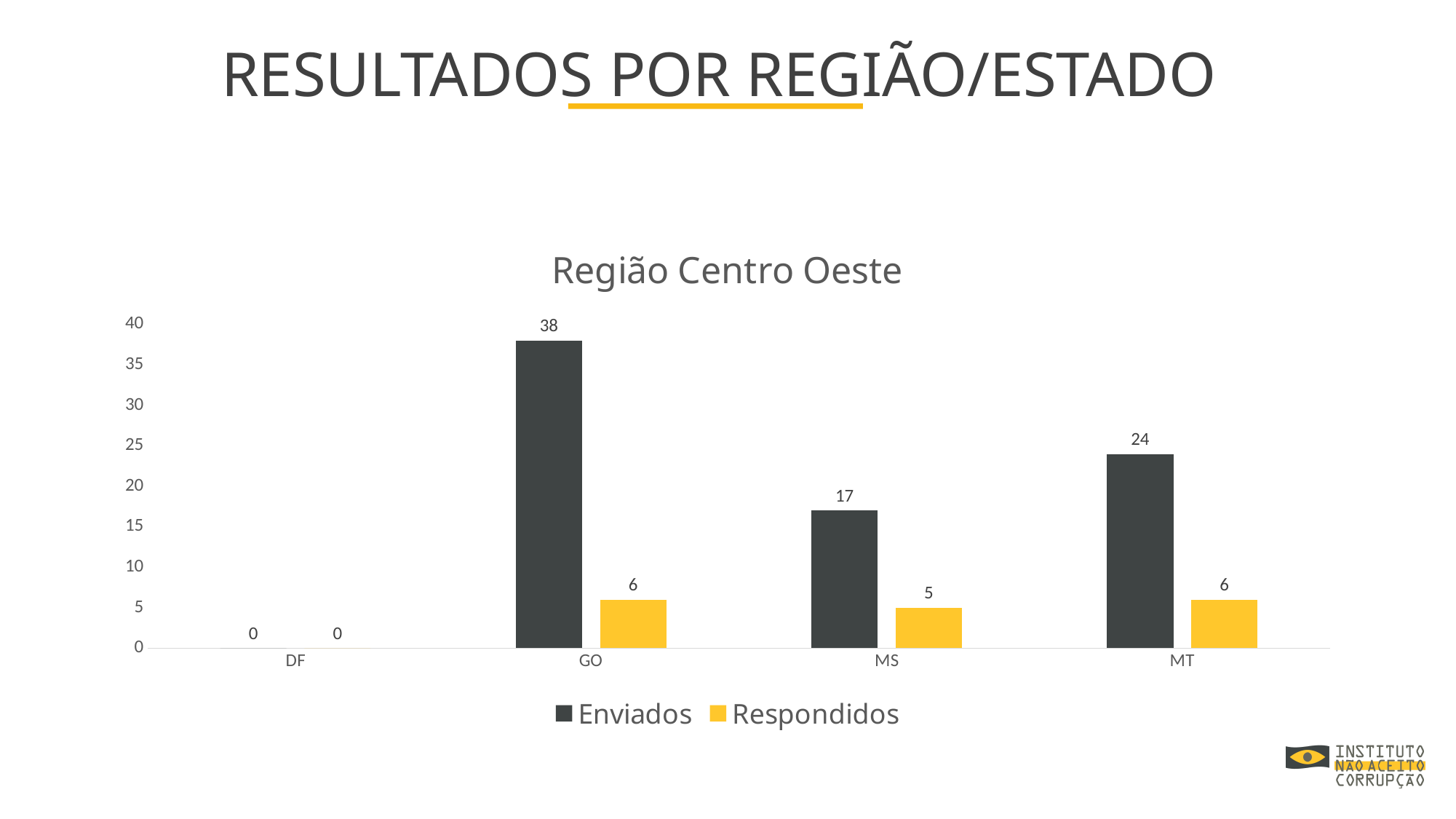
What is the value of Enviados for GO? 38 Which state has the lowest Enviados value? DF Which state has the highest Enviados value? GO What kind of chart is shown? Bar chart What is the value of Enviados for MT? 24 What is the difference between Enviados and Respondidos for GO? 32 How many states are shown on the x axis? 4 How many series does the legend list? 2 What is the difference between Enviados for MT and Enviados for MS? 7 Which is larger, Respondidos for GO or Respondidos for MS? Respondidos for GO What is the title of the chart? Região Centro Oeste What is the value of Respondidos for MS? 5